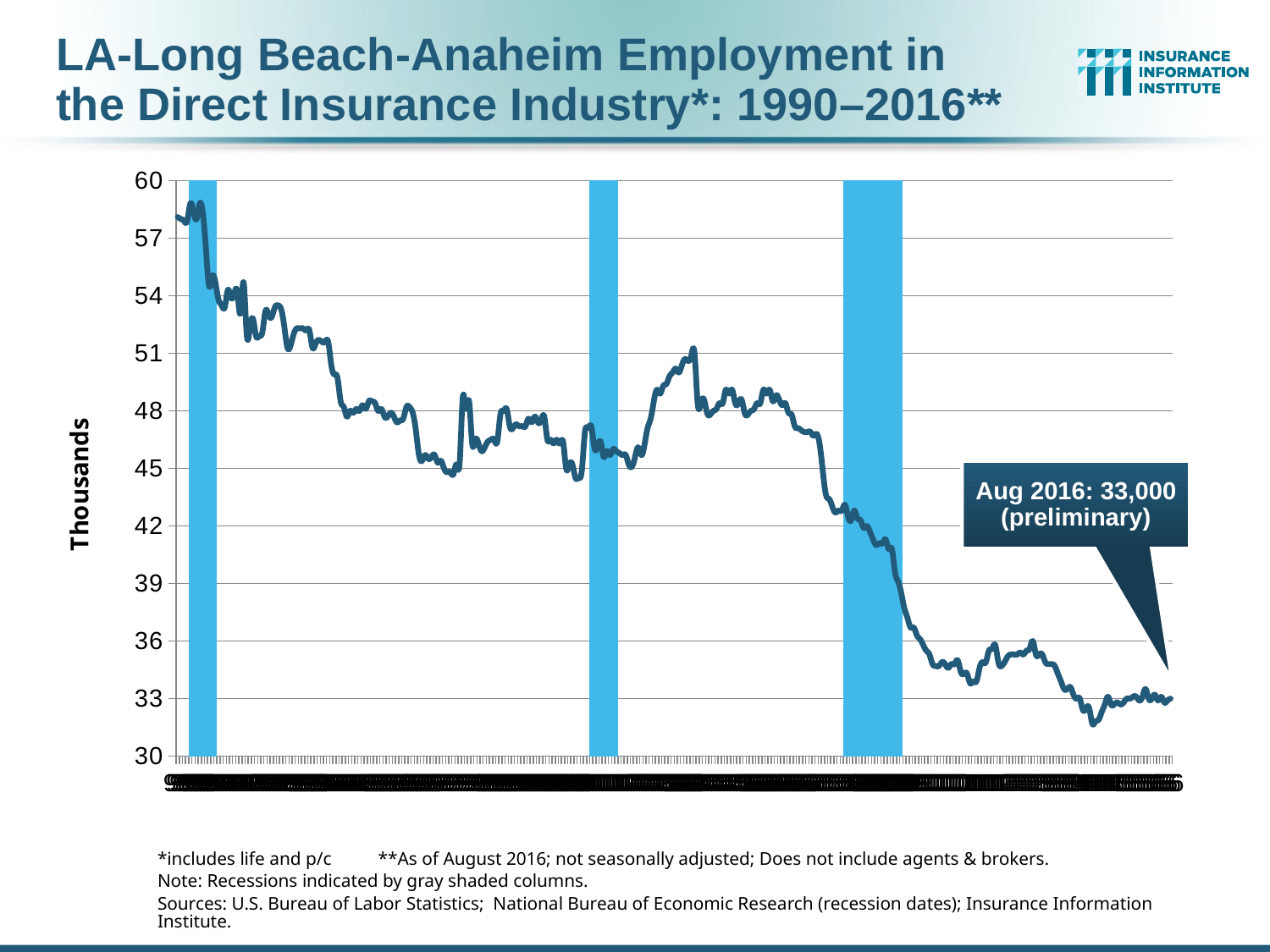
Is the employment value at the start of the series in 1990 greater or less than 57 thousand? greater What is the employment value shown for August 2016? 33,000 (preliminary) Which is larger, the employment value at the start of the series (1990) or at the end (August 2016)? 1990 Overall, do the employment values rise or fall from 1990 to 2016? Fall How many shaded recession columns are shown on the chart? 3 What unit is shown on the vertical axis label? Thousands What is the maximum value shown on the vertical axis? 60 Is the lowest point of the line near the beginning or the end of the period? End Is the highest point of the line near the beginning or the end of the period? Beginning What kind of chart is shown on the slide? Line chart Is the employment value at the end of the series in 2016 greater or less than 36 thousand? less